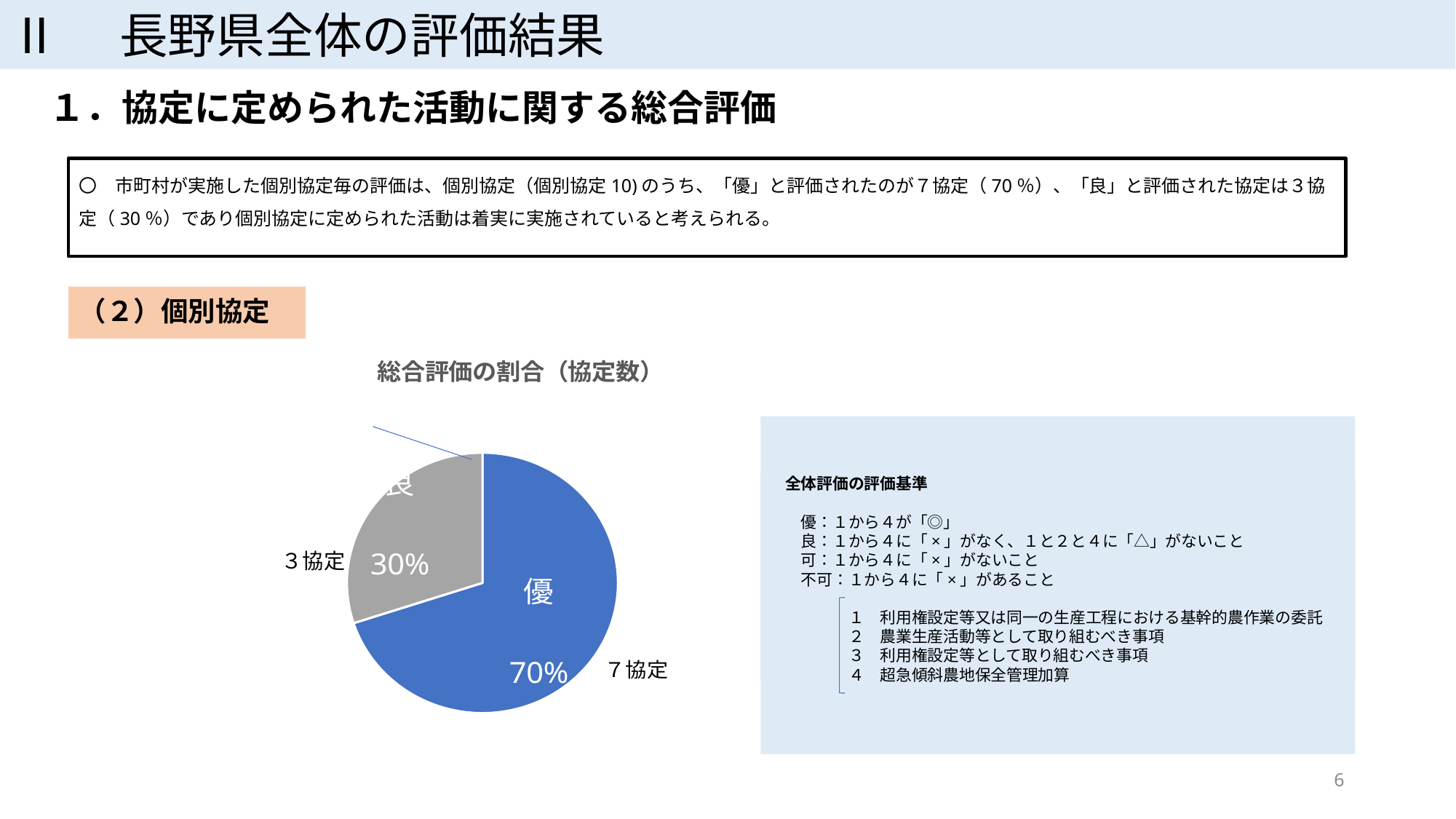
How many 協定 does the 優 slice represent? 7協定 What percentage of the pie chart is the 良 slice? 30% Which is larger, the 優 slice or the 良 slice? 優 Which slice of the pie chart is the largest? 優 What is the difference in percentage points between the 優 slice and the 良 slice? 40% How many slices does the pie chart have? 2 What colour is the 優 slice of the pie chart? blue What kind of chart is shown under the title 総合評価の割合（協定数）? pie chart What percentage of the pie chart is the 優 slice? 70% What is the title of the pie chart? 総合評価の割合（協定数） Which slice of the pie chart is the smallest? 良 How many 協定 does the 良 slice represent? 3協定